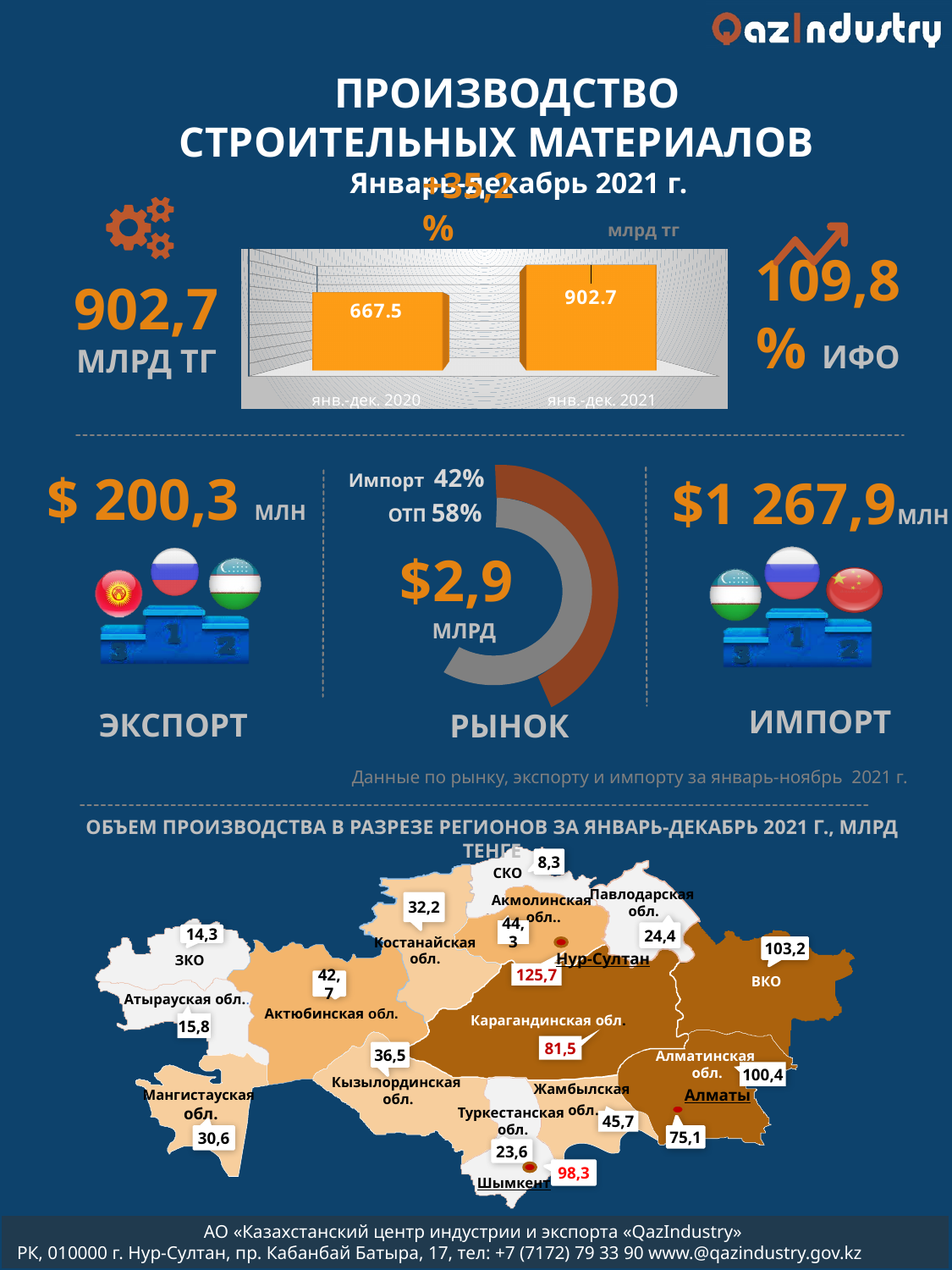
On the bar chart at the top of the slide, which period has the lower value? янв.-дек. 2020 On the donut chart in the РЫНОК section, what share is labelled ОТП? 58% On the bar chart at the top of the slide, what is the value for янв.-дек. 2020? 667.5 On the bar chart at the top of the slide, what unit is shown above the chart? млрд тг On the bar chart at the top of the slide, do the values rise or fall from 2020 to 2021? rise On the bar chart at the top of the slide, which period has the higher value? янв.-дек. 2021 On the donut chart in the РЫНОК section, what share is labelled Импорт? 42% What kind of chart is shown at the top of the slide under the title? bar chart On the donut chart in the РЫНОК section, which segment is larger, Импорт or ОТП? ОТП On the bar chart at the top of the slide, what is the difference between the 2021 and 2020 values? 235.2 On the bar chart at the top of the slide, how many bars are plotted? 2 On the bar chart at the top of the slide, what is the value for янв.-дек. 2021? 902.7